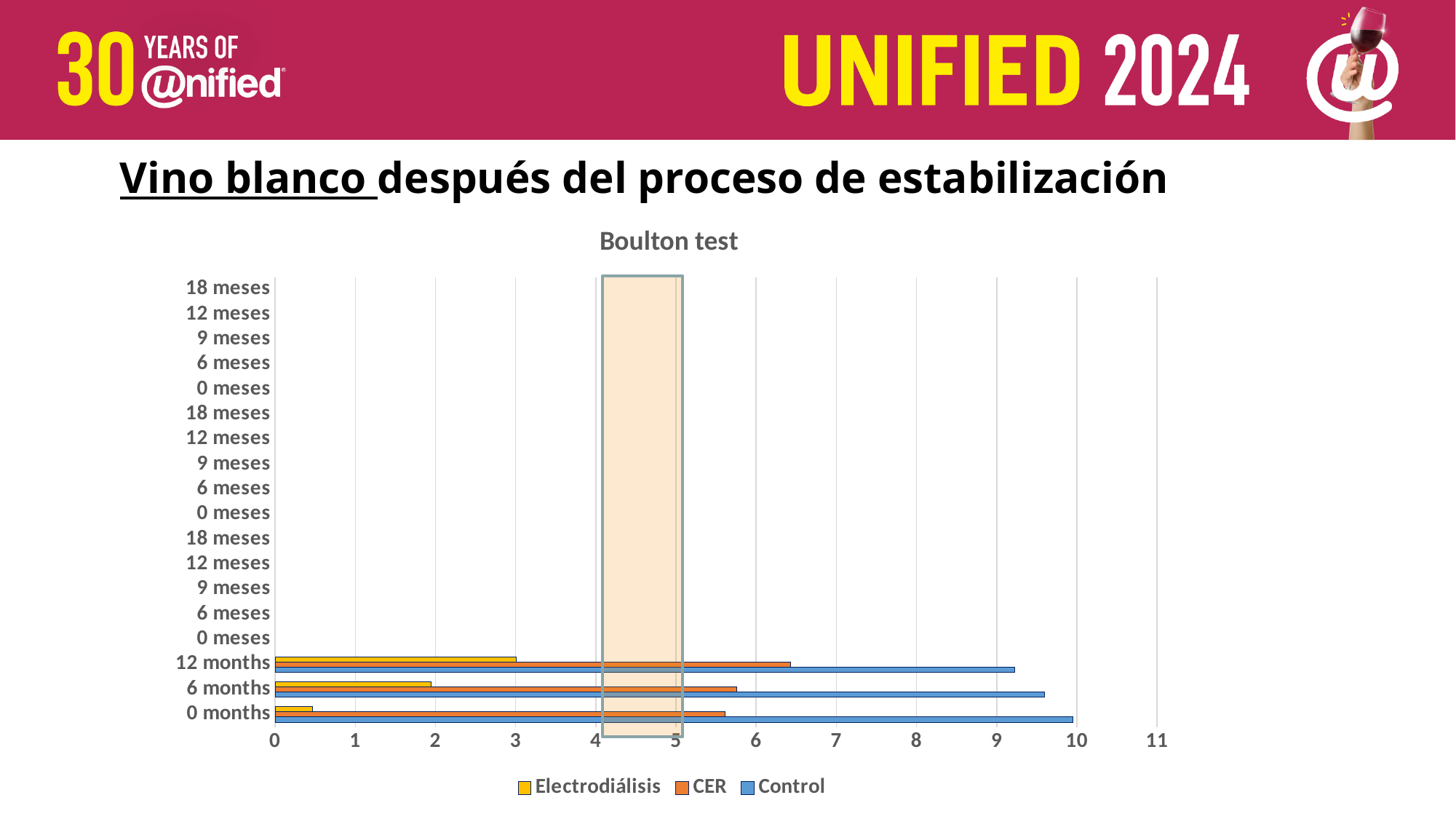
Is the Control value for 0 months greater or less than 9? greater Which series has the highest value for 12 months? Control What kind of chart is shown under the title 'Boulton test'? bar chart For 0 months, which is larger: the Control value or the CER value? Control How many series does the legend of the Boulton test chart list? 3 Is the CER value for 12 months greater or less than 6? greater Which series has the lowest value for 6 months? Electrodiálisis Is the Electrodiálisis value for 0 months greater or less than 1? less Do the Electrodiálisis values rise or fall from 0 months to 12 months? rise How many categories in the Boulton test chart actually have bars plotted? 3 What are the three series named in the legend of the Boulton test chart? Electrodiálisis, CER, Control